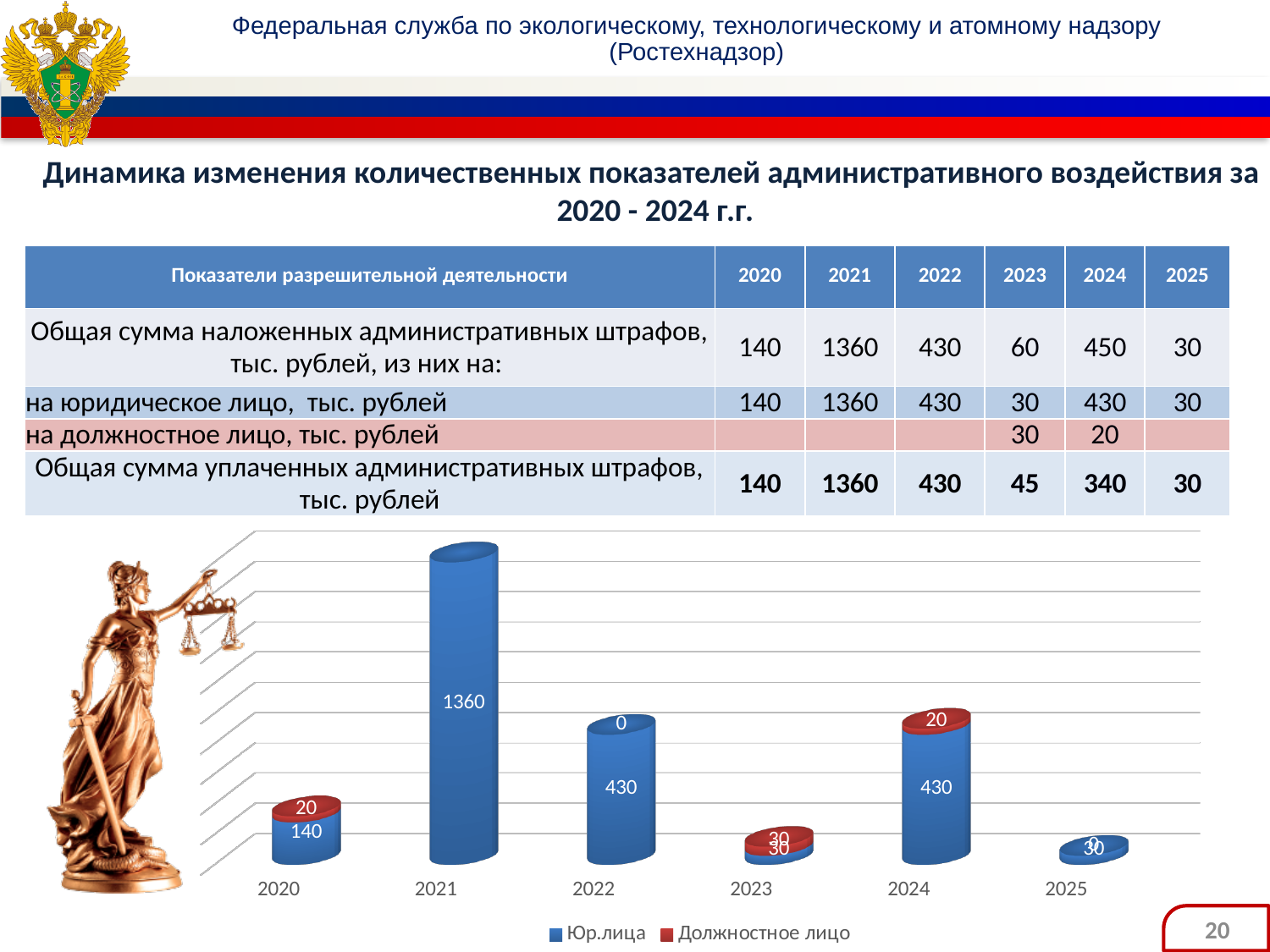
How many series does the chart legend list? 2 What type of chart is shown at the bottom of the slide? bar chart What is the difference between the Юр.лица values for 2021 and 2022 on the chart? 930 How many year categories are shown on the x axis of the chart? 6 Which is larger on the chart: the Юр.лица value for 2020 or for 2024? 2024 Which year has the highest value for Юр.лица on the chart? 2021 What is the value for Юр.лица in 2022 on the chart? 430 What is the value for Юр.лица in 2020 on the chart? 140 What is the value for Юр.лица in 2021 on the chart? 1360 Which colour represents the Должностное лицо series in the chart? red What is the total of the stacked bar for 2024 on the chart? 450 What is the value for Должностное лицо in 2024 on the chart? 20